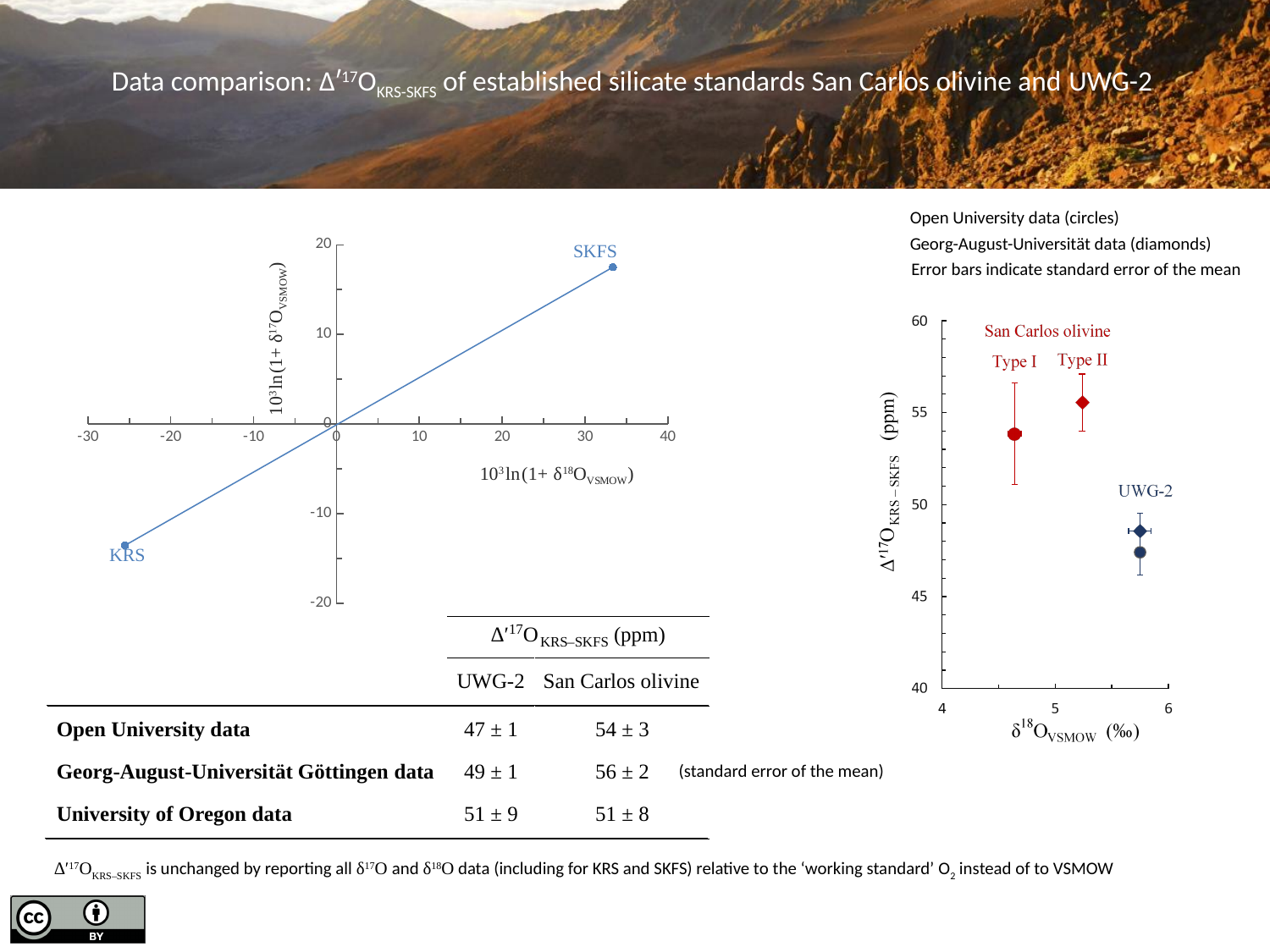
On the left chart, what are the labels of the two plotted points? KRS and SKFS On the left chart, which point has the higher y-axis value, KRS or SKFS? SKFS On the right chart, which sample has the lowest plotted Δ′17O value, San Carlos olivine or UWG-2? UWG-2 On the right chart, is the value for San Carlos olivine Type I greater or less than 55? less What kind of chart is the right chart? scatter chart On the left chart, is the y-axis value for KRS greater or less than -10? less On the left chart, is the x-axis value for SKFS greater or less than 30? greater On the right chart, which has the higher Δ′17O value, San Carlos olivine Type I or UWG-2? San Carlos olivine Type I On the left chart, how many data points are plotted? 2 On the right chart, which marker shape represents Open University data? circles On the left chart, does the line rise or fall from KRS to SKFS? rises